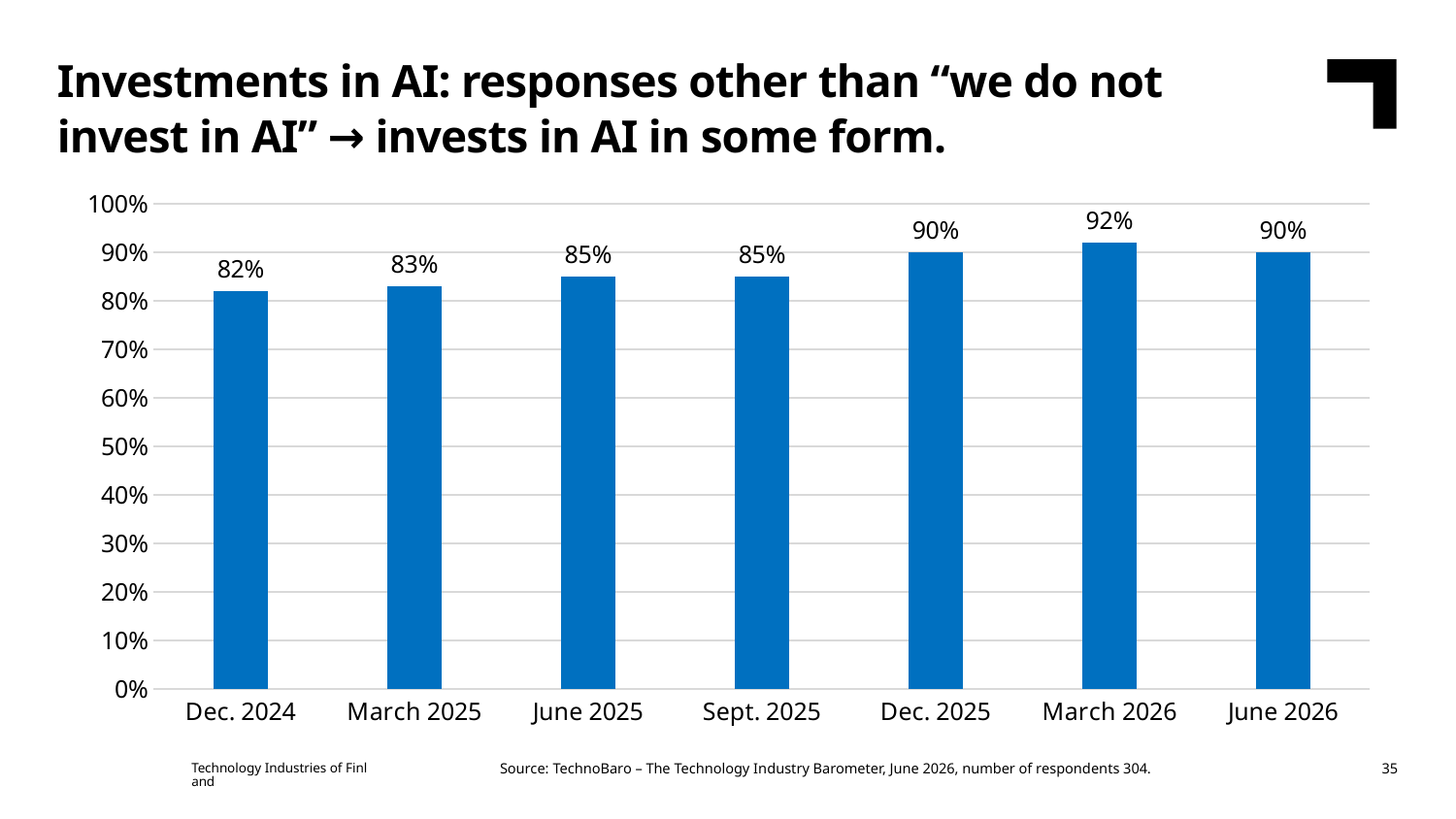
What is the difference between the values for Dec. 2025 and June 2025? 5% What is the value for March 2026? 92% How many periods are shown on the x axis? 7 What is the value for Sept. 2025? 85% What is the value for Dec. 2024? 82% Which is larger, the value for March 2025 or the value for June 2026? June 2026 What is the difference between the values for March 2026 and Dec. 2024? 10% What kind of chart is shown on the slide? Bar chart Which period has the lowest value? Dec. 2024 Is the value for June 2025 greater or less than 80%? greater Do the values generally rise or fall from Dec. 2024 to March 2026? Rise Which period has the highest value? March 2026